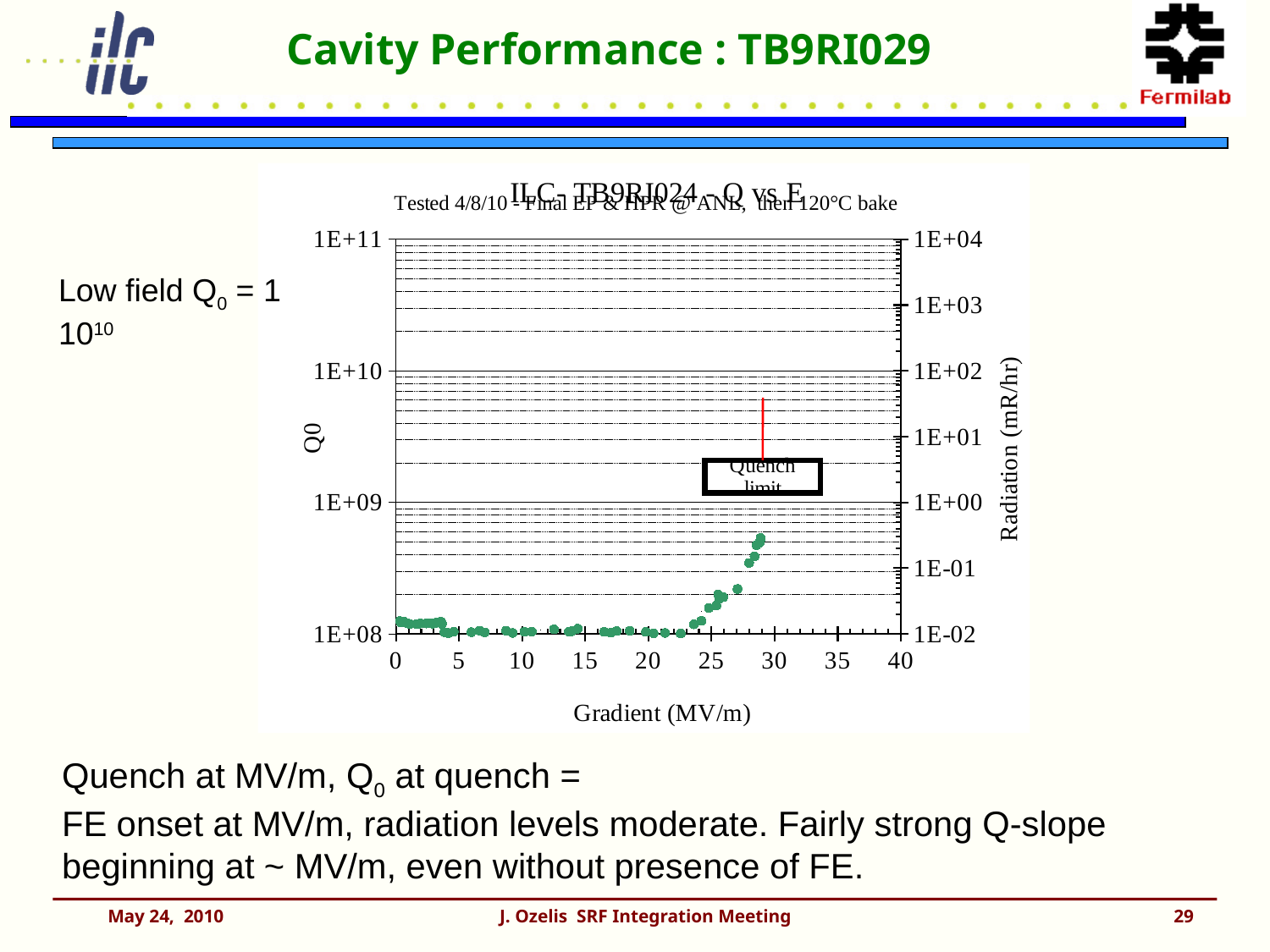
What is the highest tick value shown on the right y axis (Radiation) of the chart? 1E+04 What kind of chart is shown on the slide? scatter chart What is the title of the x axis of the chart? Gradient (MV/m) What is the maximum value shown on the x axis of the chart? 40 What is the title of the right-hand y axis of the chart? Radiation (mR/hr) Do the plotted points rise or fall as the gradient increases beyond 25 MV/m? rise What is the lowest tick value shown on the left y axis (Q0) of the chart? 1E+08 What is the highest tick value shown on the left y axis (Q0) of the chart? 1E+11 Is the gradient of the highest plotted point greater or less than 25 MV/m? greater Is the gradient at which the red 'Quench limit' line is drawn greater or less than 25 MV/m? greater What is the spacing between consecutive tick marks on the x axis of the chart? 5 What is the lowest tick value shown on the right y axis (Radiation) of the chart? 1E-02